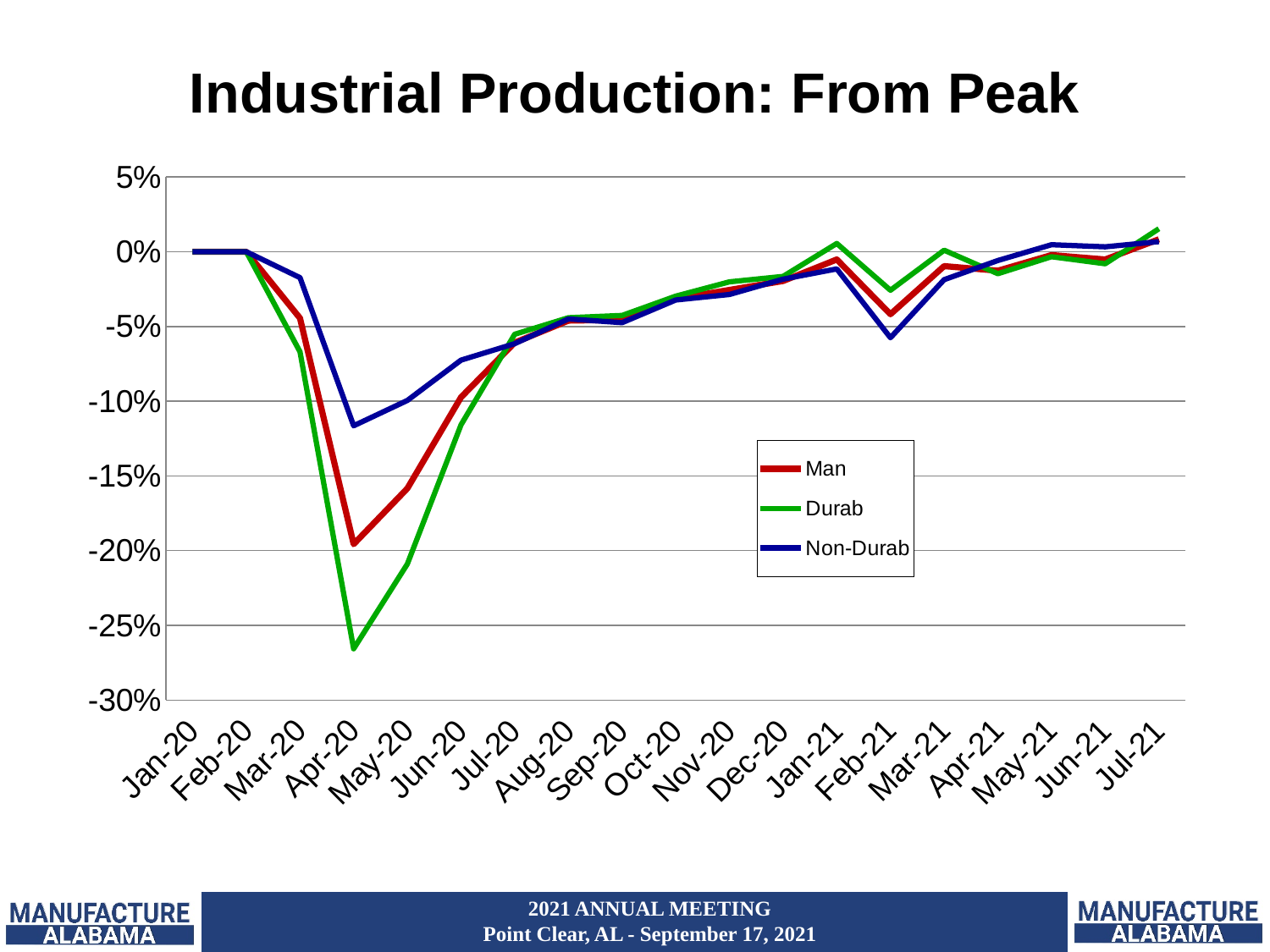
How many months are plotted along the x axis? 19 How many series does the legend list? 3 In Feb-21, which is larger, the value for Man or the value for Durab? Durab In Apr-20, which is larger, the value for Durab or the value for Non-Durab? Non-Durab Do the values for Durab rise or fall from Apr-20 to Jul-20? rise Is the value for Man in May-20 greater or less than -15%? less Which series reaches the lowest value in Apr-20? Durab Is the value for Non-Durab in Feb-21 greater or less than -5%? less Is the value for Non-Durab in Apr-20 greater or less than -10%? less What is the title of the chart? Industrial Production: From Peak What kind of chart is shown on the slide? line chart